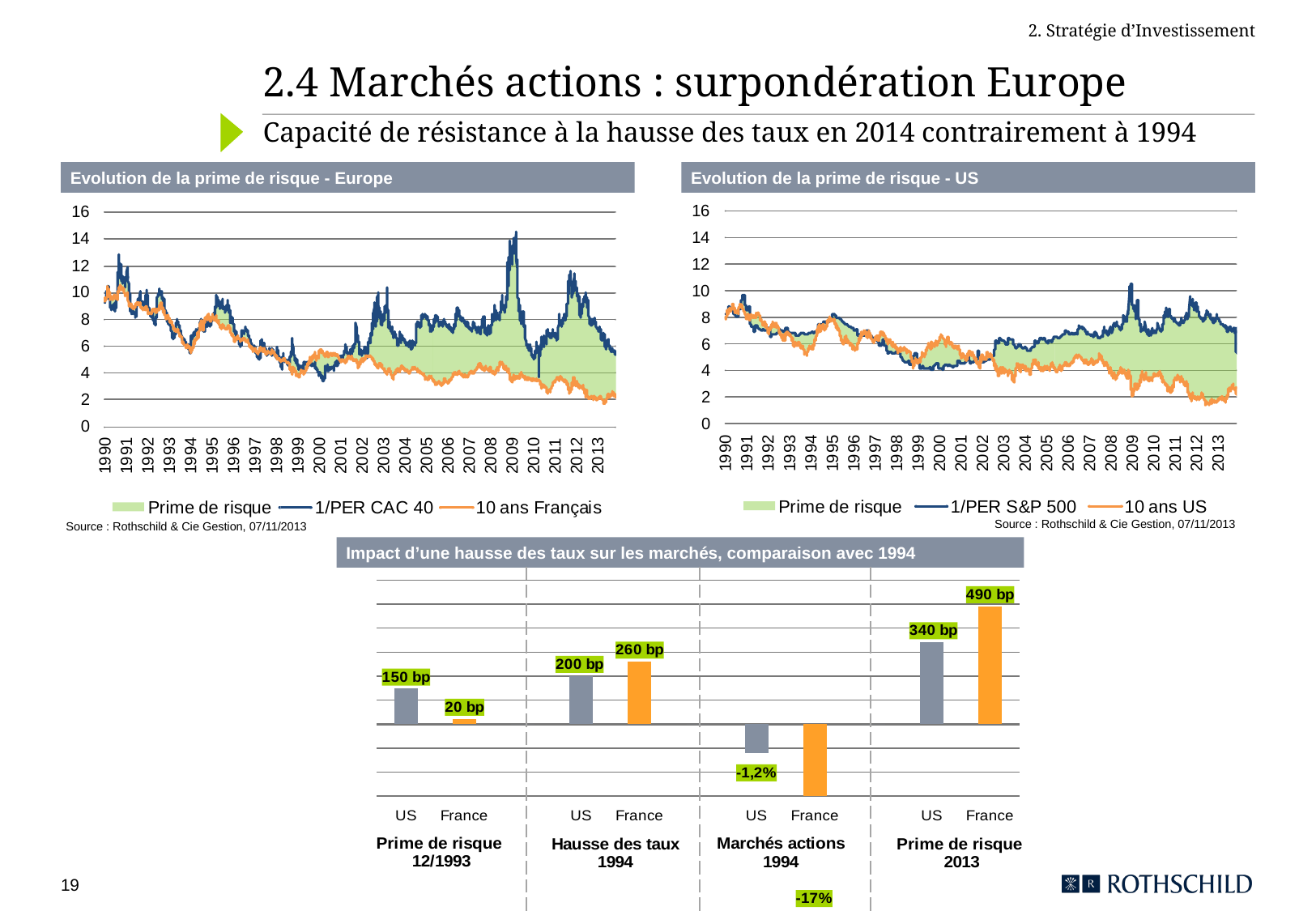
In the chart 'Impact d'une hausse des taux sur les marchés, comparaison avec 1994', what is the difference between the France and US values under 'Prime de risque 2013'? 150 bp In the chart 'Evolution de la prime de risque - Europe', does the '10 ans Français' line generally rise or fall from 1990 to 2013? Fall In the chart 'Impact d'une hausse des taux sur les marchés, comparaison avec 1994', what is the value for France under 'Prime de risque 2013'? 490 bp In the chart 'Impact d'une hausse des taux sur les marchés, comparaison avec 1994', what is the value for US under 'Prime de risque 12/1993'? 150 bp In the chart 'Evolution de la prime de risque - Europe', is the value of '10 ans Français' in 2013 greater or less than 4? less In the chart 'Impact d'une hausse des taux sur les marchés, comparaison avec 1994', what is the value for France under 'Marchés actions 1994'? -17% In the chart 'Impact d'une hausse des taux sur les marchés, comparaison avec 1994', which is larger under 'Hausse des taux 1994', US or France? France In the chart 'Impact d'une hausse des taux sur les marchés, comparaison avec 1994', which bar has the lowest value? France, Marchés actions 1994 (-17%) How many series does the legend of the chart 'Evolution de la prime de risque - Europe' list? 3 In the chart 'Evolution de la prime de risque - US', what are the three legend entries? Prime de risque, 1/PER S&P 500, 10 ans US What kind of chart is 'Impact d'une hausse des taux sur les marchés, comparaison avec 1994'? Bar chart In the chart 'Impact d'une hausse des taux sur les marchés, comparaison avec 1994', what is the value for US under 'Hausse des taux 1994'? 200 bp